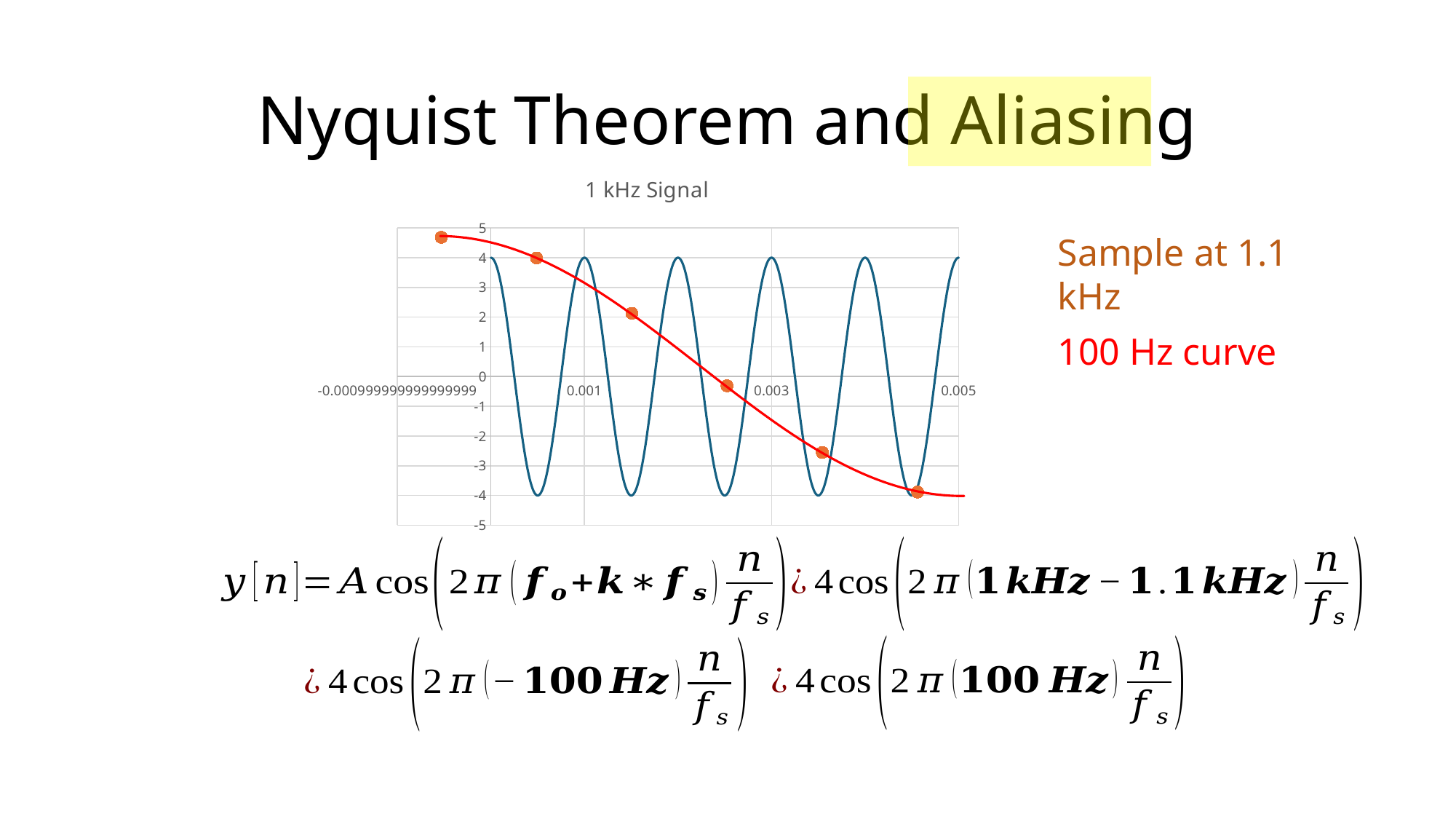
What colour is the 100 Hz curve in the chart? red What is the title of the chart? 1 kHz Signal Does the red 100 Hz curve rise or fall from left to right across the chart? fall Is the value of the third orange sample point from the left greater or less than 1? greater Is the value of the leftmost orange sample point greater or less than 4? greater How many orange sample points are plotted on the chart? 6 What is the maximum value reached by the blue 1 kHz signal curve? 4 Is the value of the rightmost orange sample point greater or less than -3? less Which is larger, the value of the leftmost orange sample point or the value of the rightmost orange sample point? the leftmost orange sample point What kind of chart is shown on the slide? line chart What is the minimum value reached by the blue 1 kHz signal curve? -4